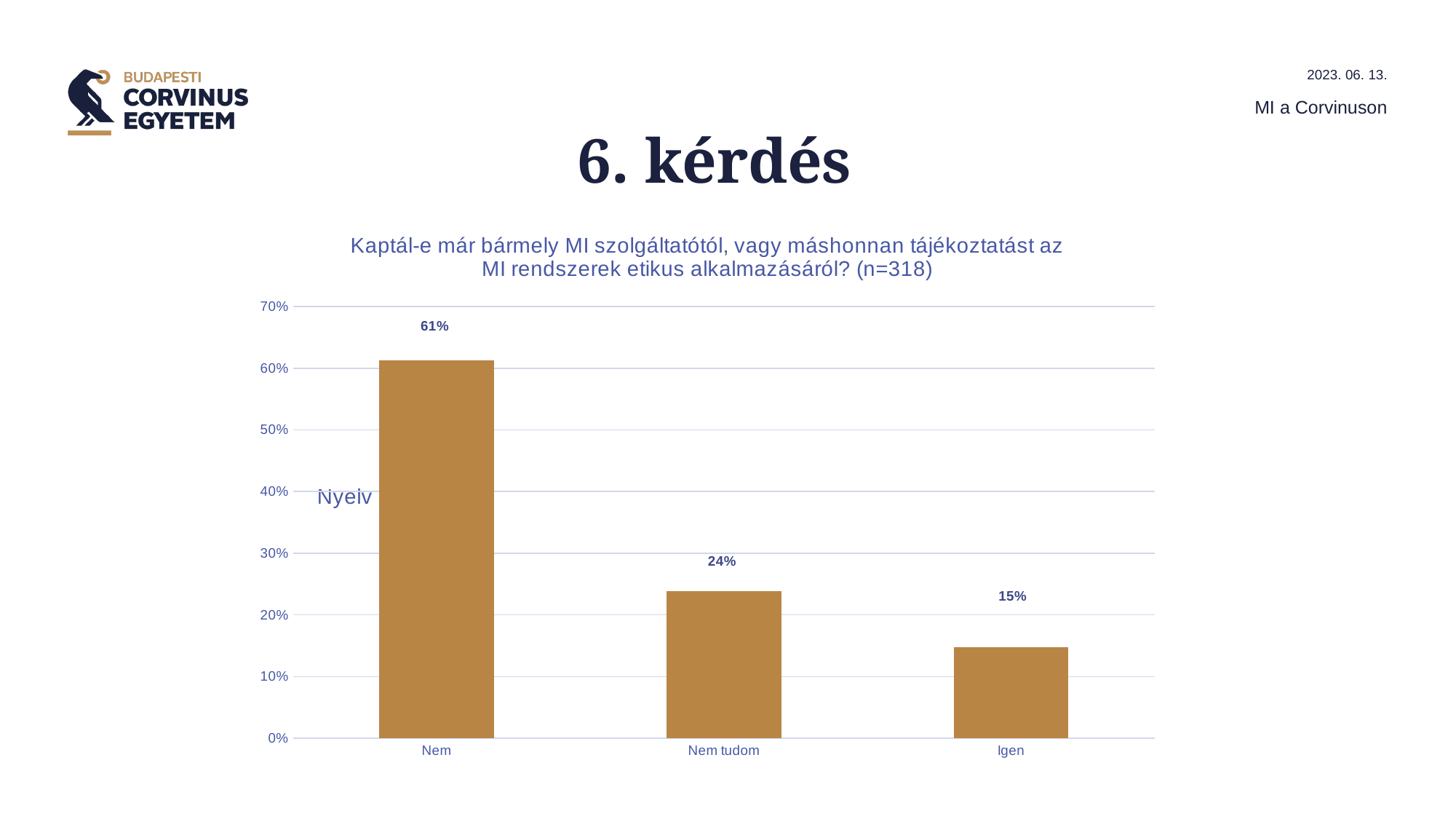
What is the difference between the values for "Nem tudom" and "Igen"? 9% What is the value for "Nem tudom"? 24% What sample size (n) is stated in the chart title? n=318 What is the difference between the values for "Nem" and "Igen"? 46% What is the value for "Igen"? 15% Which is larger, the value for "Nem tudom" or the value for "Igen"? Nem tudom Is the value for "Nem" greater or less than 50%? greater How many categories are shown on the x axis? 3 What kind of chart is shown on the slide? bar chart Which category has the highest value? Nem What is the value for "Nem"? 61% Which category has the lowest value? Igen